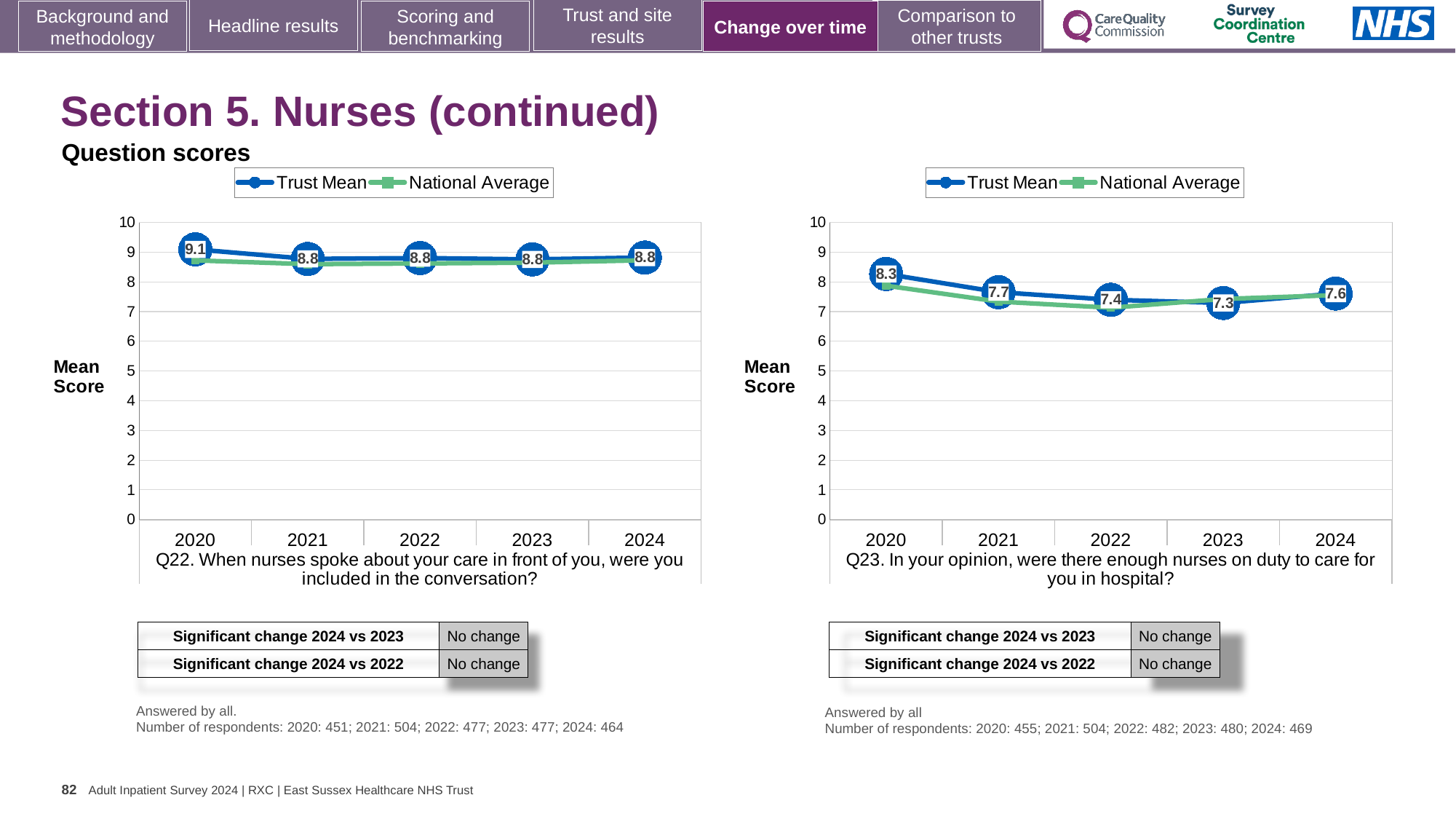
What type of chart is used for Q22 on the left? Line chart In the Q23 chart on the right, is the Trust Mean score for 2024 greater or less than 8? less In the Q23 chart on the right, what is the Trust Mean score for 2022? 7.4 In the Q22 chart on the left, what is the Trust Mean score for 2024? 8.8 How many years are shown on the x axis of the Q22 chart on the left? 5 In the Q22 chart on the left, what is the difference between the Trust Mean scores for 2020 and 2021? 0.3 In the Q23 chart on the right, which year has the highest Trust Mean score? 2020 Which is larger: the Trust Mean score for 2024 in the Q22 chart or the Trust Mean score for 2024 in the Q23 chart? Q22 chart (8.8) In the Q22 chart on the left, what is the Trust Mean score for 2020? 9.1 In the Q23 chart on the right, what is the difference between the Trust Mean scores for 2020 and 2024? 0.7 How many series does the legend of the Q23 chart on the right list? 2 In the Q23 chart on the right, which year has the lowest Trust Mean score? 2023